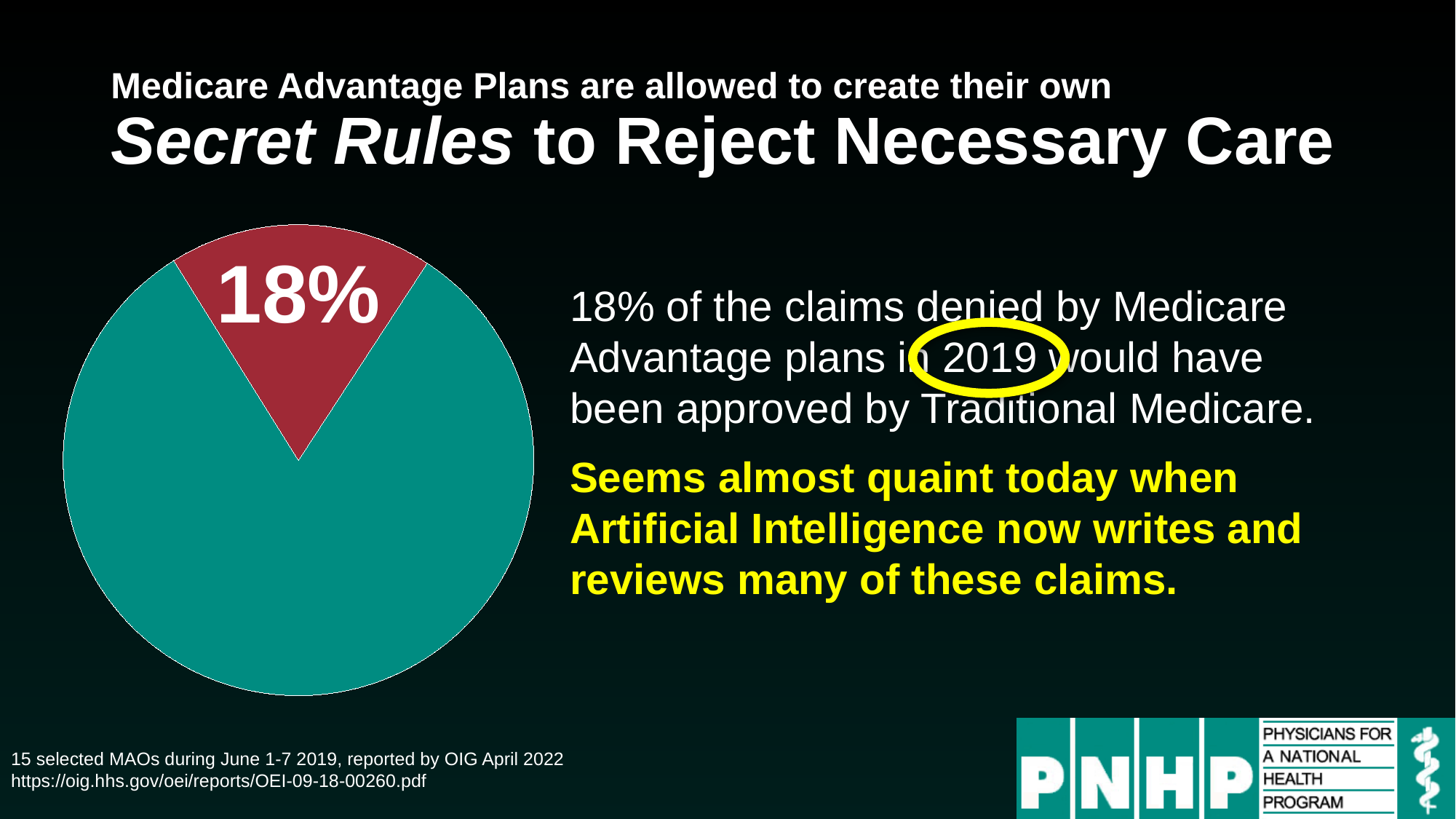
Does the pie chart include a legend? No Which slice of the pie chart is the largest? the teal slice What share of the pie does the labelled red slice represent? 18% How many slices does the pie chart have? 2 What percentage is printed on the red slice of the pie chart? 18% According to the slide, what percentage of claims denied by Medicare Advantage plans in 2019 would have been approved by Traditional Medicare? 18% Which slice of the pie chart is the smallest? the red slice (18%) What colour is the slice labelled 18% in the pie chart? red Which slice of the pie chart is larger, the red slice or the teal slice? the teal slice What kind of chart is shown on the slide? pie chart